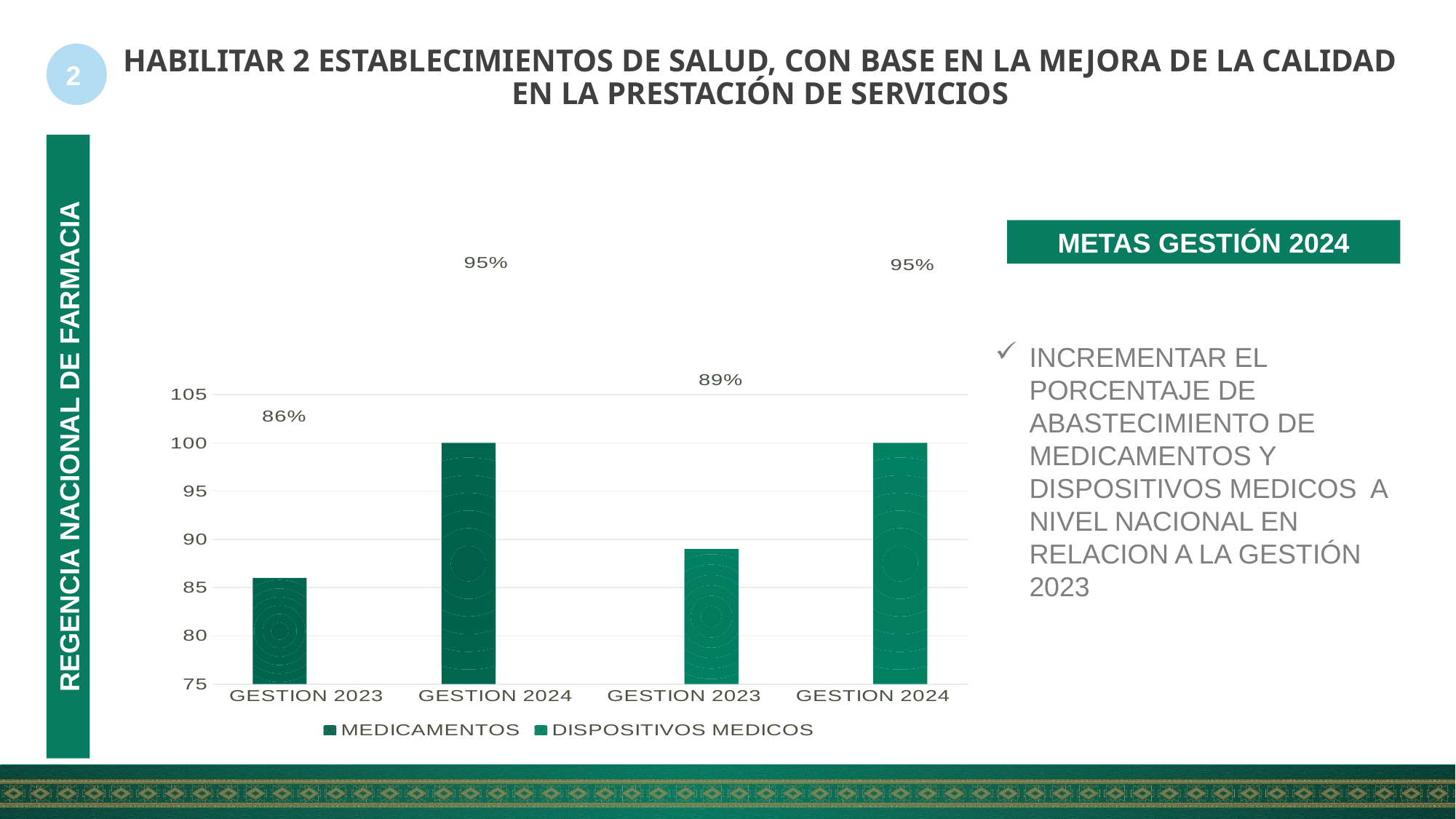
What value is shown for MEDICAMENTOS in GESTION 2023? 86% What value is shown for DISPOSITIVOS MEDICOS in GESTION 2023? 89% What kind of chart is shown on the slide? bar chart Is the value for MEDICAMENTOS in GESTION 2023 greater or less than 90? less What value is shown for MEDICAMENTOS in GESTION 2024? 95% How many bars are plotted in the chart? 4 How many series does the legend list? 2 In GESTION 2023, which is larger: MEDICAMENTOS or DISPOSITIVOS MEDICOS? DISPOSITIVOS MEDICOS Which bar has the lowest value in the chart? MEDICAMENTOS, GESTION 2023 What value is shown for DISPOSITIVOS MEDICOS in GESTION 2024? 95%